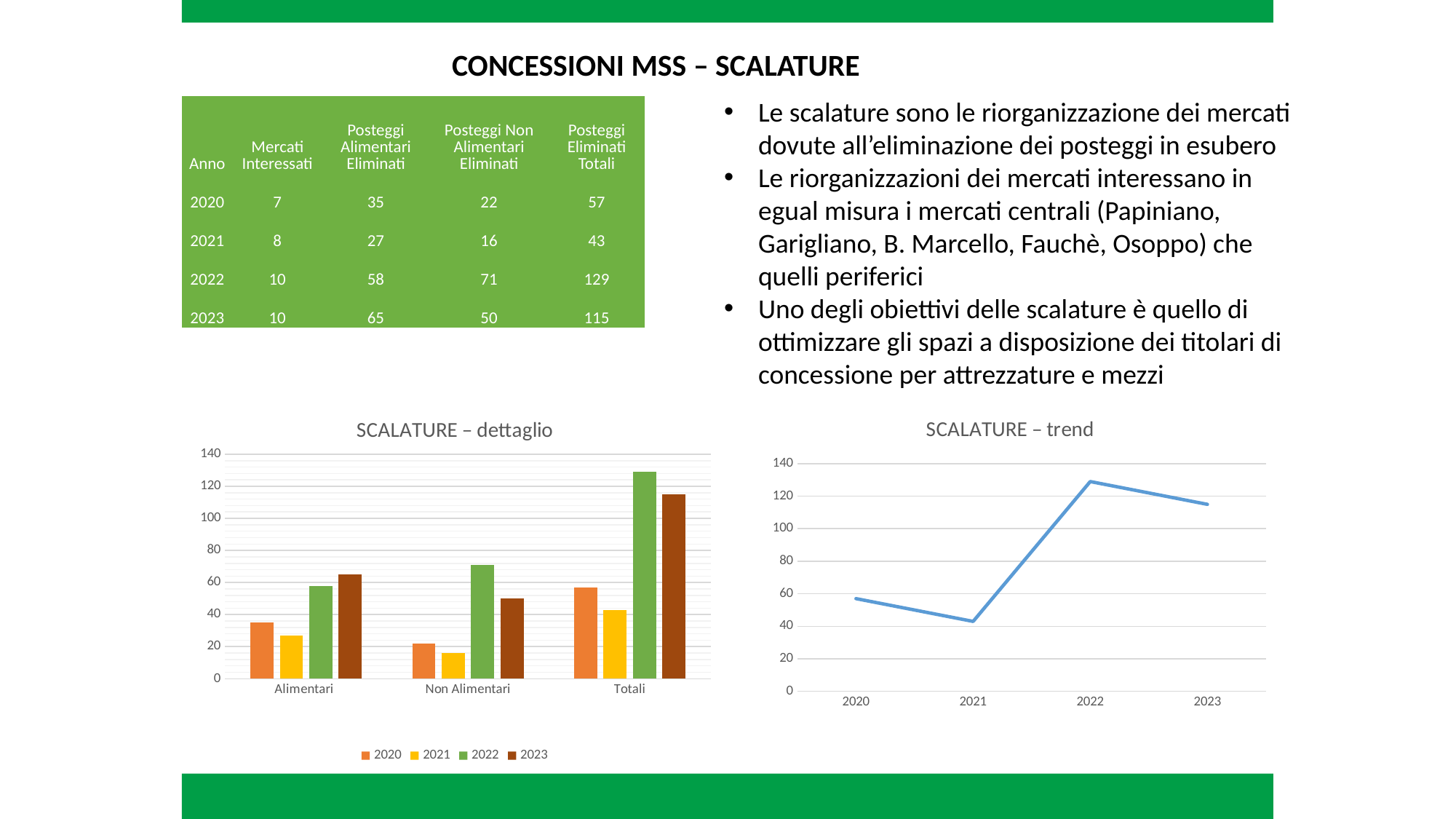
In the "SCALATURE – trend" chart, which year has the lowest value? 2021 In the "SCALATURE – dettaglio" chart, is the 2021 bar for Non Alimentari greater or less than 20? less In the "SCALATURE – trend" chart, does the line rise or fall from 2022 to 2023? fall In the "SCALATURE – dettaglio" chart, how many categories are shown on the x axis? 3 What kind of chart is "SCALATURE – trend"? line chart In the "SCALATURE – dettaglio" chart, which year has the highest bar for Non Alimentari? 2022 In the "SCALATURE – trend" chart, is the value for 2022 greater or less than 120? greater What kind of chart is "SCALATURE – dettaglio"? bar chart In the "SCALATURE – dettaglio" chart, for Alimentari, which is larger: the 2022 bar or the 2023 bar? 2023 In the "SCALATURE – trend" chart, how many years are plotted? 4 In the "SCALATURE – trend" chart, which year has the highest value? 2022 In the "SCALATURE – dettaglio" chart, how many series does the legend list? 4